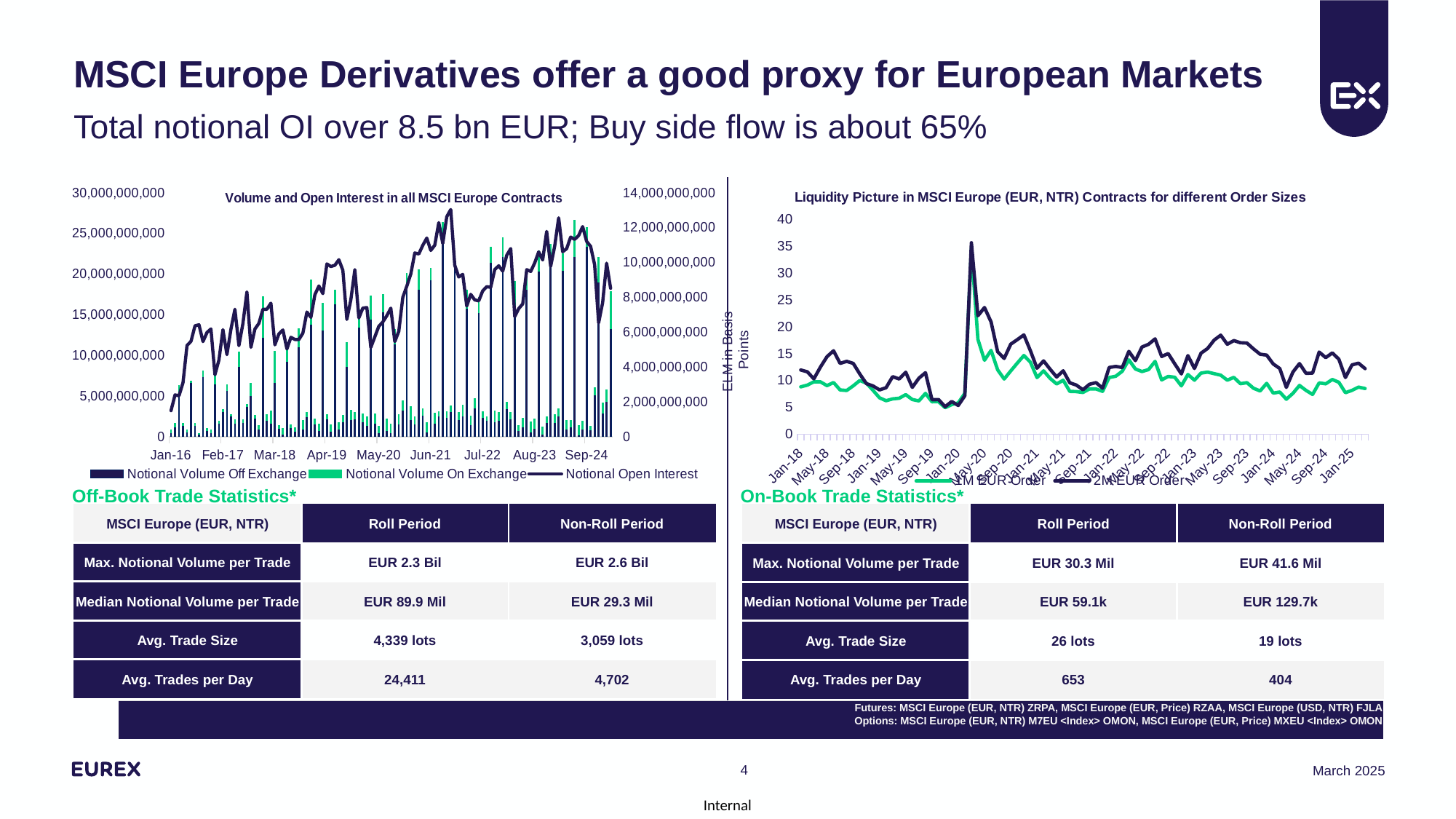
What kind of chart is the 'Liquidity Picture in MSCI Europe (EUR, NTR) Contracts for different Order Sizes' chart? line chart In the 'Liquidity Picture' chart, is the peak value of the 1M EUR Order series greater or less than 20? greater How many series does the legend of the 'Volume and Open Interest in all MSCI Europe Contracts' chart list? 3 In the 'Liquidity Picture' chart, is the value of the 2M EUR Order series at Jan-25 greater or less than 15? less In the 'Volume and Open Interest in all MSCI Europe Contracts' chart, which series is drawn as a line rather than bars? Notional Open Interest In the 'Liquidity Picture' chart, is the peak value of the 2M EUR Order series greater or less than 30? greater How many series does the legend of the 'Liquidity Picture in MSCI Europe (EUR, NTR) Contracts for different Order Sizes' chart list? 2 In the 'Liquidity Picture' chart, which series is generally higher across the period, 1M EUR Order or 2M EUR Order? 2M EUR Order In the 'Volume and Open Interest in all MSCI Europe Contracts' chart, does the Notional Open Interest line overall rise or fall from Jan-16 to Jun-21? rise What is the y-axis label of the 'Liquidity Picture in MSCI Europe (EUR, NTR) Contracts for different Order Sizes' chart? ELM in Basis Points